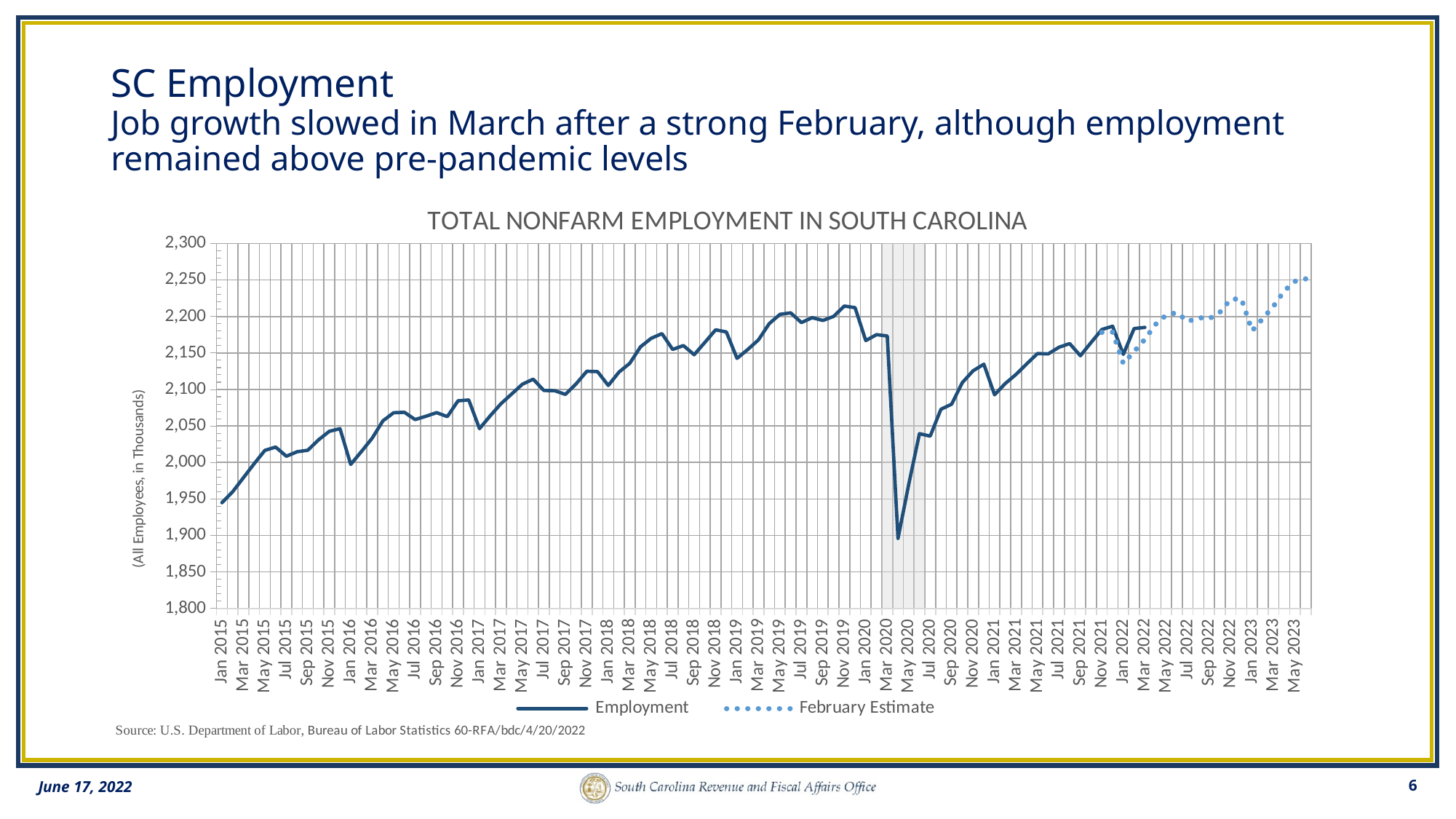
Is the lowest Employment value in 2020 greater or less than 1,950? less Does the Employment line generally rise or fall from Jan 2015 to Dec 2019? rise How many series does the chart legend list? 2 Which is larger, the Employment value for Jan 2015 or for Jan 2020? Jan 2020 What kind of chart is shown on the slide? line chart Is the Employment value for Jan 2015 greater or less than 2,000? less In which year does the Employment line reach its lowest point? 2020 Is the Employment value for Mar 2022 greater or less than 2,150? greater What are the two series named in the chart legend? Employment and February Estimate What is the title of the chart? TOTAL NONFARM EMPLOYMENT IN SOUTH CAROLINA